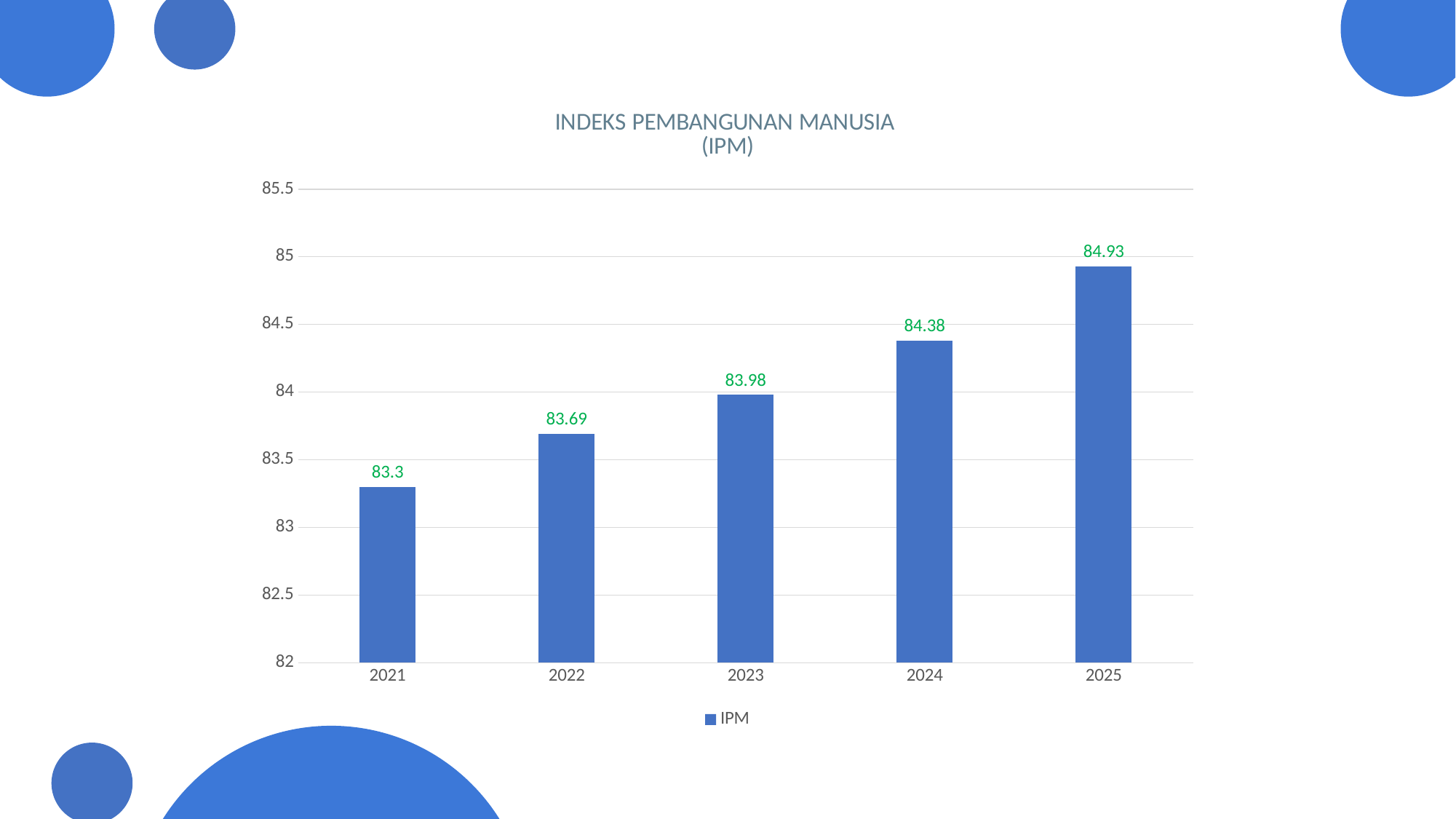
What is the difference between the IPM values for 2025 and 2024? 0.55 How many years are shown on the x axis? 5 Do the IPM values rise or fall from 2021 to 2025? Rise What is the IPM value for 2021? 83.3 Is the IPM value for 2024 greater or less than 84? greater What kind of chart is shown on the slide? Bar chart Which year has a larger IPM value, 2022 or 2024? 2024 What is the IPM value for 2025? 84.93 What is the IPM value for 2023? 83.98 Which year has the lowest IPM value? 2021 What is the difference between the IPM values for 2022 and 2021? 0.39 Which year has the highest IPM value? 2025